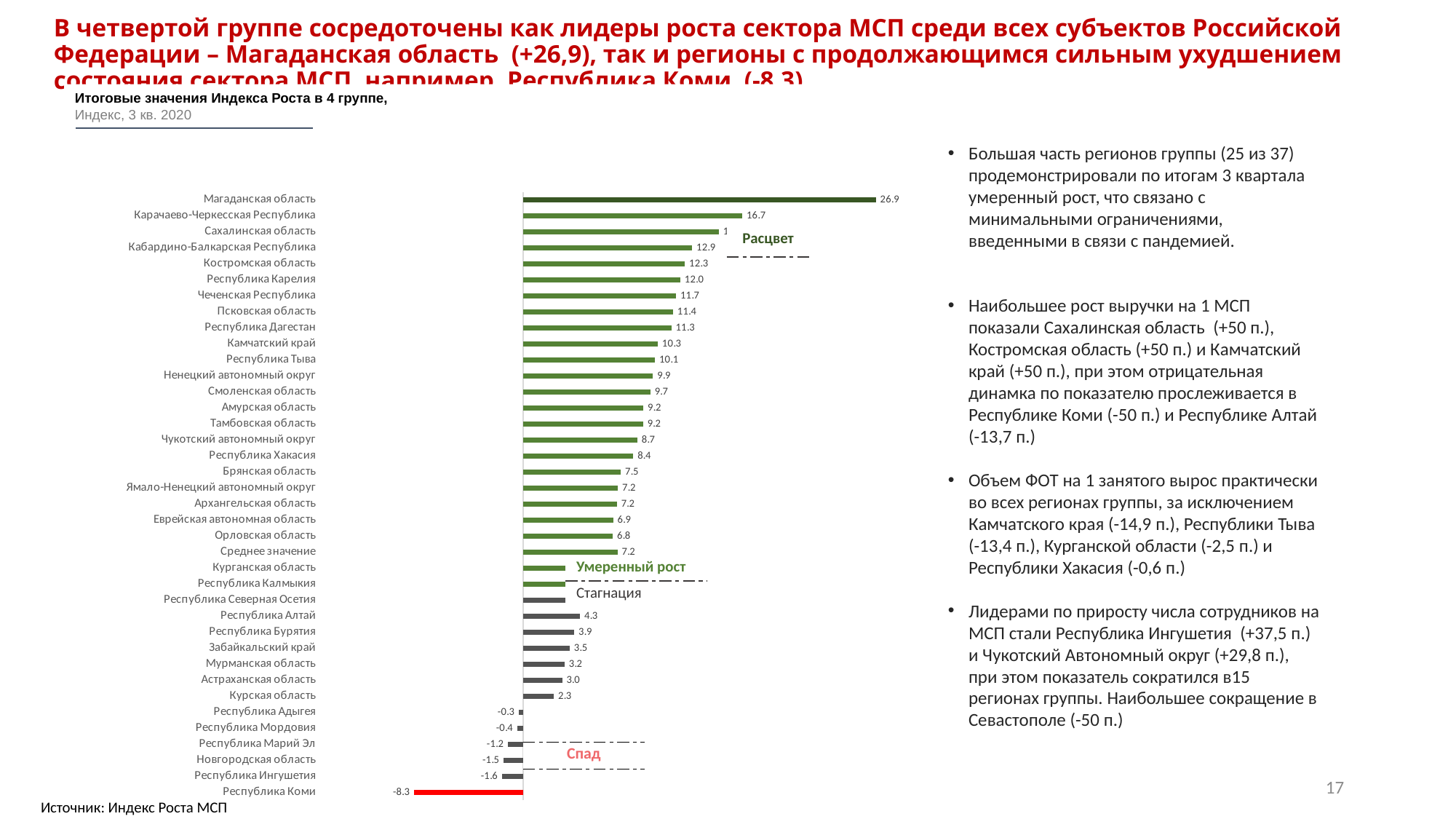
What is the value shown for Среднее значение? 7.2 What colour is the bar for Республика Коми? Red What is the index value for Магаданская область? 26.9 What is the index value for Республика Алтай? 4.3 What is the index value for Костромская область? 12.3 Which region has the lowest index value? Республика Коми What is the index value for Республика Коми? -8.3 What is the difference between the values for Магаданская область and Карачаево-Черкесская Республика? 10.2 Which has a higher index value, Камчатский край or Республика Тыва? Камчатский край How many bars are plotted in the chart? 38 Which region has the highest index value? Магаданская область What type of chart is shown on the slide? Bar chart